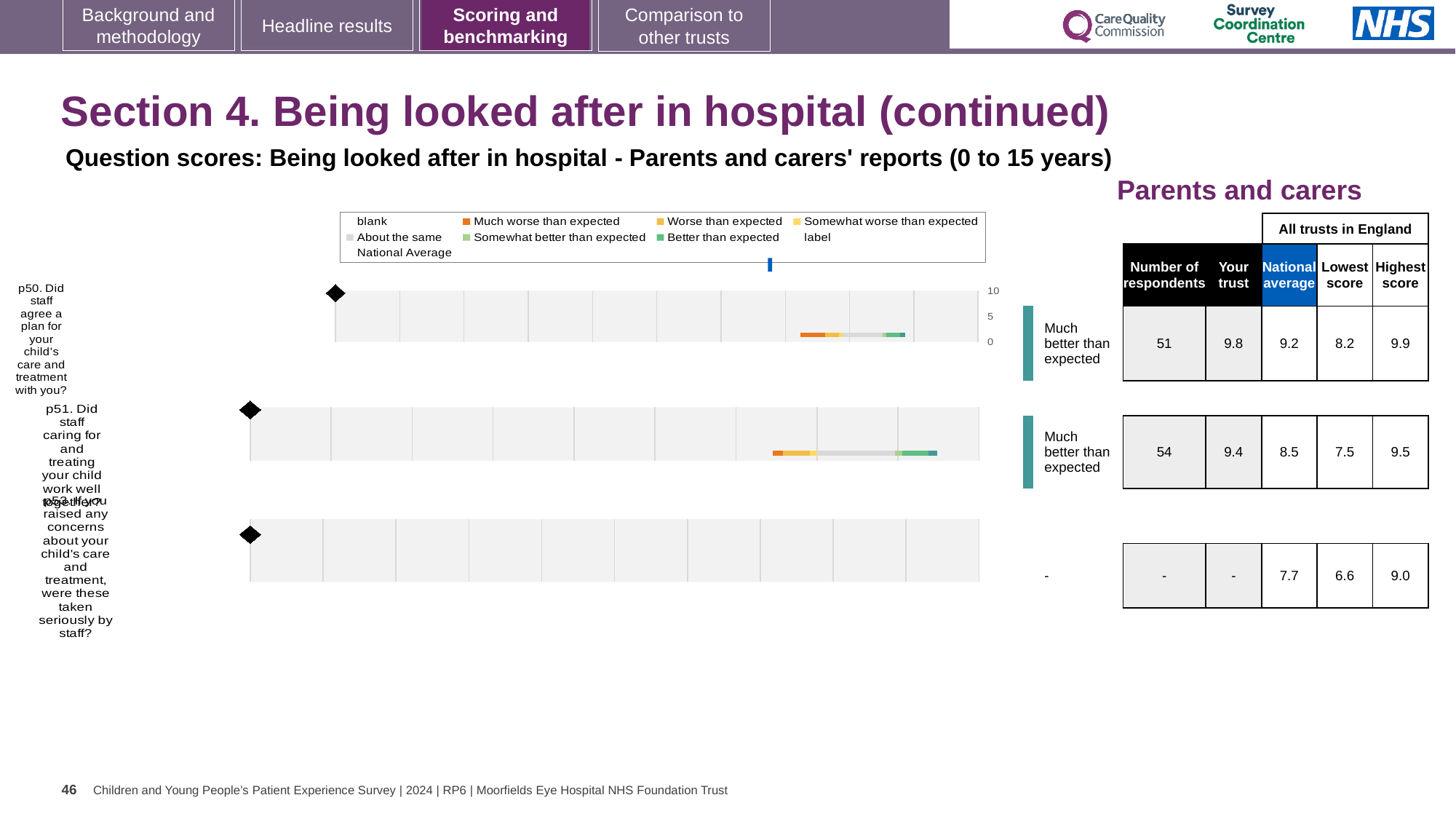
What is the National average score for p51 (Did staff caring for and treating your child work well together?)? 8.5 For p50, what is the difference between the 'Your trust' score (9.8) and the National average (9.2)? 0.6 What kind of chart is used to show the question scores on this slide? Bar chart What benchmark category is shown for p51? Much better than expected For p50, which is larger: the 'Your trust' score or the National average? Your trust How many respondents answered p51? 54 For p51, what is the difference between the Highest score (9.5) and the Lowest score (7.5)? 2.0 How many questions (p50, p51, p53) are plotted on the chart? 3 What is the 'Your trust' score for p50 (Did staff agree a plan for your child's care and treatment with you?)? 9.8 Which question has the highest 'Your trust' score? p50 What is the Highest score among all trusts in England for p53? 9.0 What is the Lowest score among all trusts in England for p50? 8.2